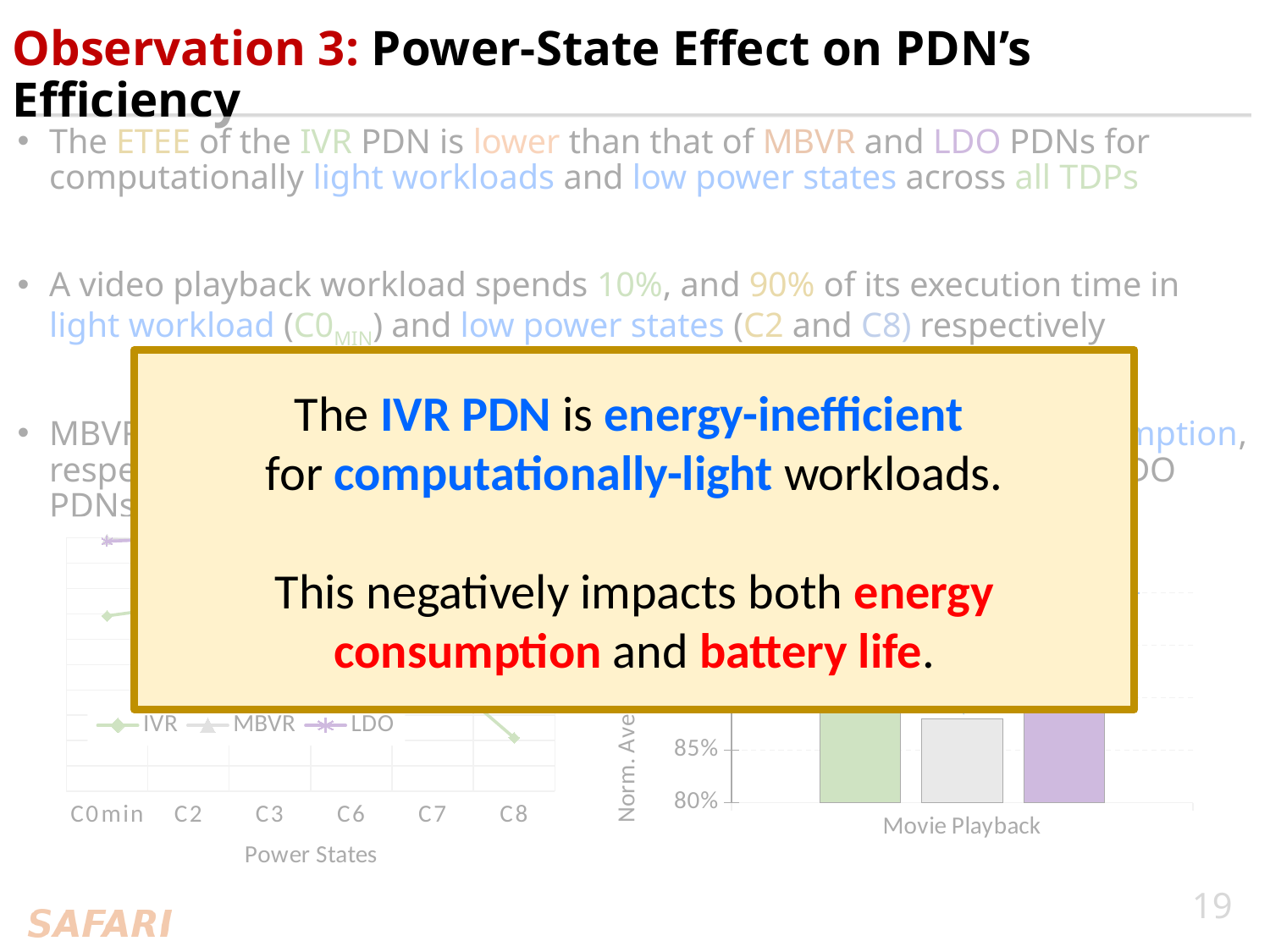
In the right chart, is the value of the green bar for Movie Playback greater or less than 85%? greater What is the first category on the x axis of the left chart? C0min How many bars are shown in the right chart for Movie Playback? 3 What is the last category on the x axis of the left chart? C8 What is the x-axis title of the left chart? Power States Which series are listed in the legend of the left chart? IVR, MBVR, LDO How many series does the legend of the left chart list? 3 What kind of chart is the chart on the right of the slide (Movie Playback)? bar chart How many power states are shown on the x axis of the left chart? 6 What is the category label on the x axis of the right chart? Movie Playback What kind of chart is the chart on the left of the slide? line chart In the right chart, is the value of the purple bar for Movie Playback greater or less than 80%? greater